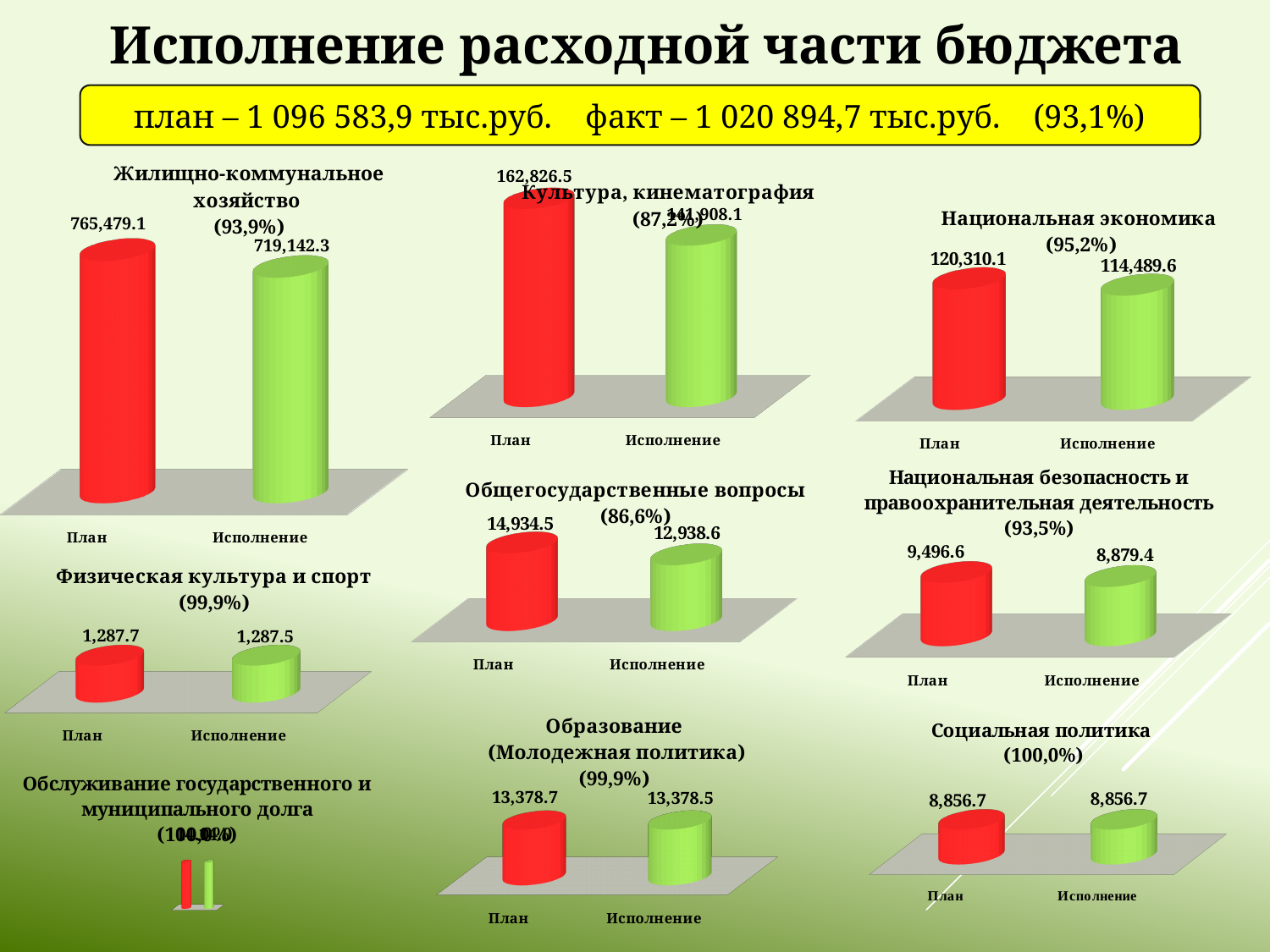
In the 'Национальная безопасность и правоохранительная деятельность' chart, what is the value for План? 9,496.6 How many categories are shown in the 'Физическая культура и спорт' chart? 2 In the 'Жилищно-коммунальное хозяйство' chart, what is the difference between План and Исполнение? 46,336.8 In the 'Жилищно-коммунальное хозяйство' chart, what is the value for Исполнение? 719,142.3 In the 'Общегосударственные вопросы' chart, what is the difference between План and Исполнение? 1,995.9 In the 'Социальная политика' chart, what is the value for Исполнение? 8,856.7 In the 'Общегосударственные вопросы' chart, which bar is higher, План or Исполнение? План In the 'Национальная экономика' chart, what is the value for Исполнение? 114,489.6 In the 'Жилищно-коммунальное хозяйство' chart, what is the value for План? 765,479.1 In the 'Культура, кинематография' chart, what is the value for План? 162,826.5 In the 'Национальная экономика' chart, what is the difference between План and Исполнение? 5,820.5 What kind of chart is the 'Образование (Молодежная политика)' chart? Bar chart